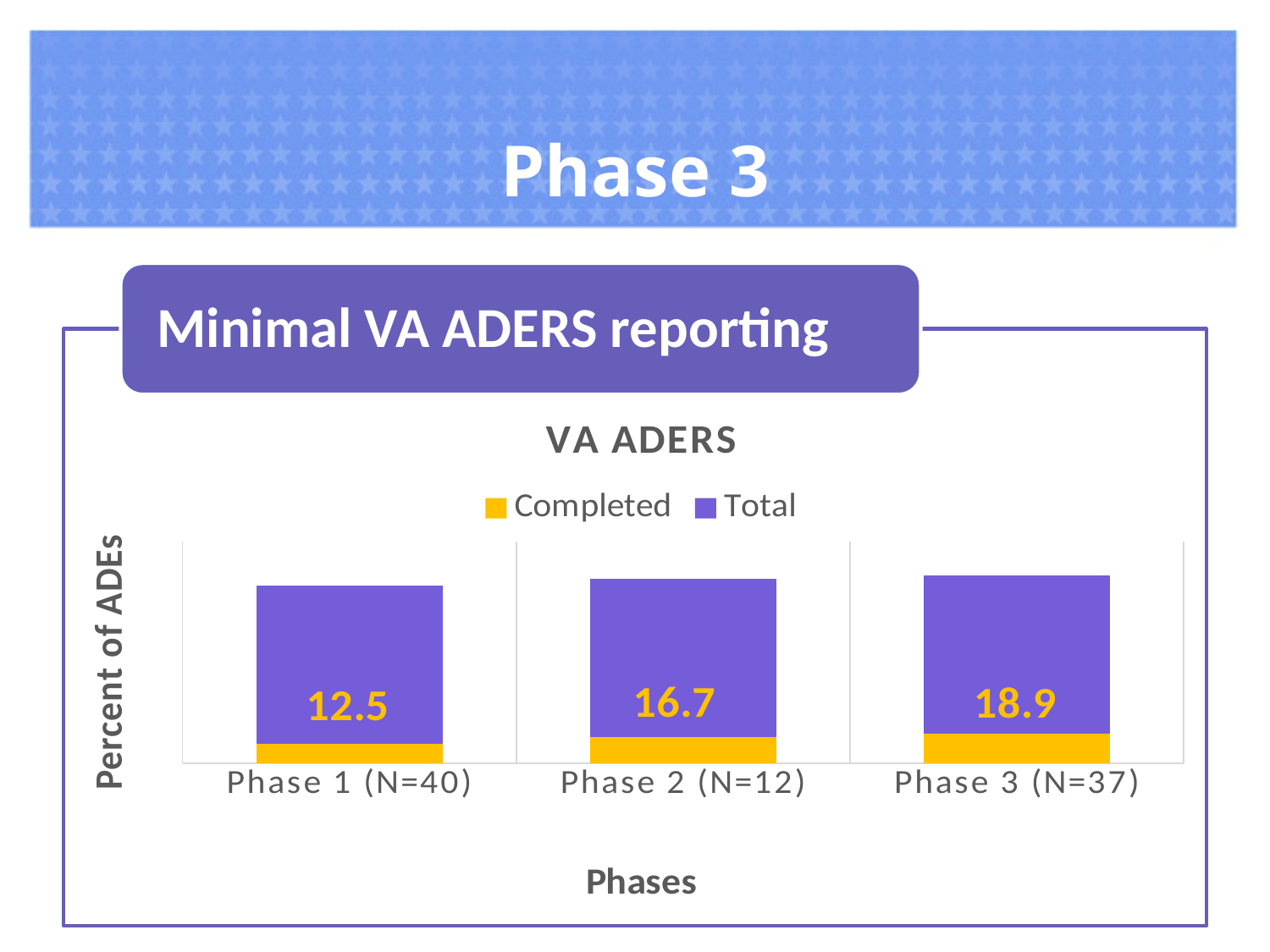
Which phase has the lowest Completed value? Phase 1 (N=40) Do the Completed values rise or fall from Phase 1 to Phase 3? Rise How many phases are shown on the x axis of the chart? 3 What is the Completed value for Phase 3 (N=37)? 18.9 What is the difference between the Completed values for Phase 3 (N=37) and Phase 1 (N=40)? 6.4 What is the Completed value for Phase 2 (N=12)? 16.7 Which phase has the highest Completed value? Phase 3 (N=37) What is the Completed value for Phase 1 (N=40)? 12.5 How many series does the chart legend list? 2 Which has a larger Completed value, Phase 2 (N=12) or Phase 3 (N=37)? Phase 3 (N=37) What is the difference between the Completed values for Phase 2 (N=12) and Phase 1 (N=40)? 4.2 What kind of chart is shown on the slide? Stacked bar chart